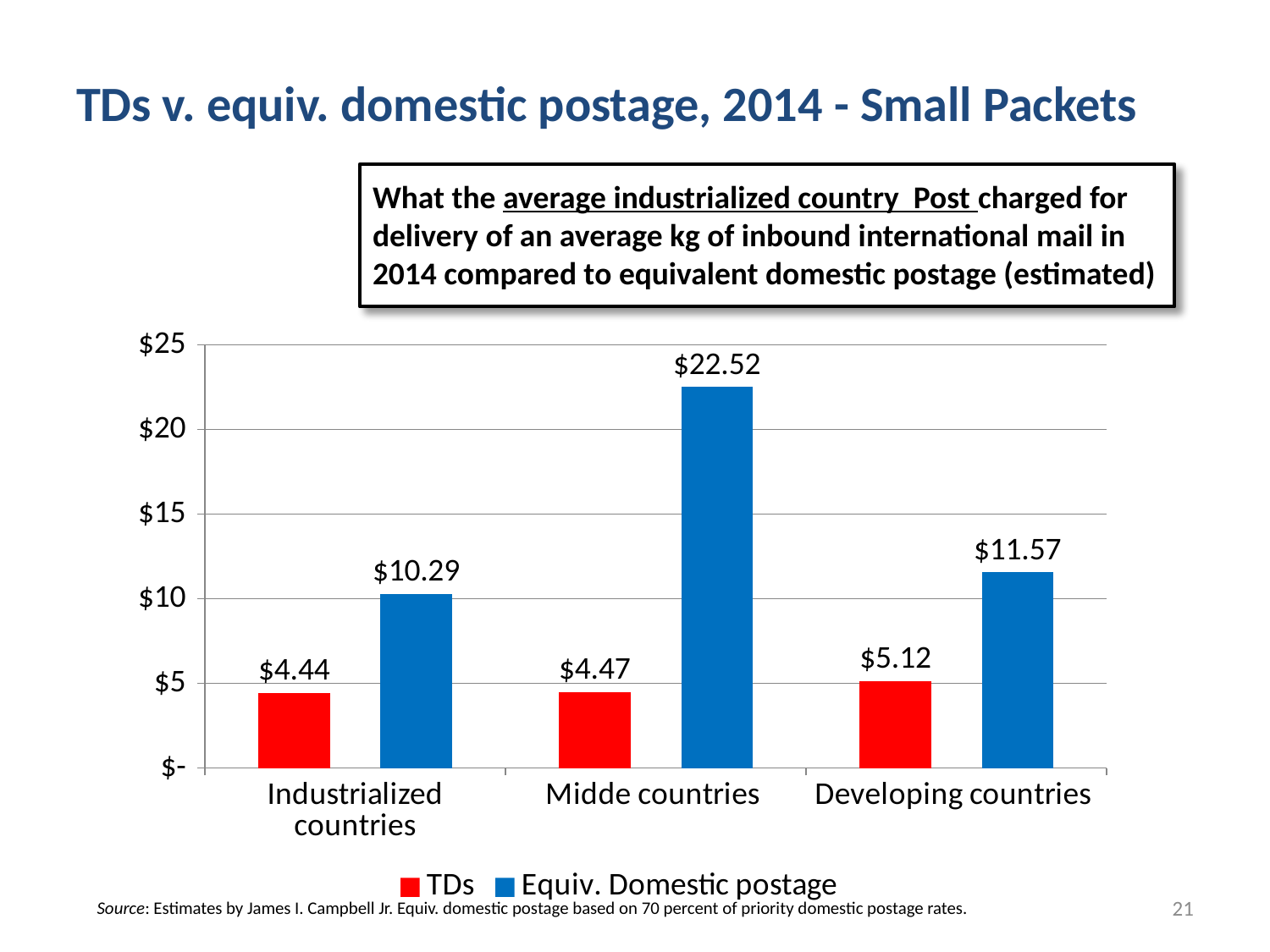
What is the difference between Equiv. Domestic postage and TDs for Midde countries? $18.05 What is the Equiv. Domestic postage value for Midde countries? $22.52 Which category has the lowest TDs value? Industrialized countries What is the Equiv. Domestic postage value for Developing countries? $11.57 Is the Equiv. Domestic postage value for Industrialized countries greater or less than $15? less What kind of chart is shown on the slide? bar chart Which category has the highest Equiv. Domestic postage value? Midde countries How many series does the legend list? 2 How many categories are shown on the x axis? 3 What is the TDs value for Industrialized countries? $4.44 Which is larger for Industrialized countries: TDs or Equiv. Domestic postage? Equiv. Domestic postage What is the TDs value for Developing countries? $5.12